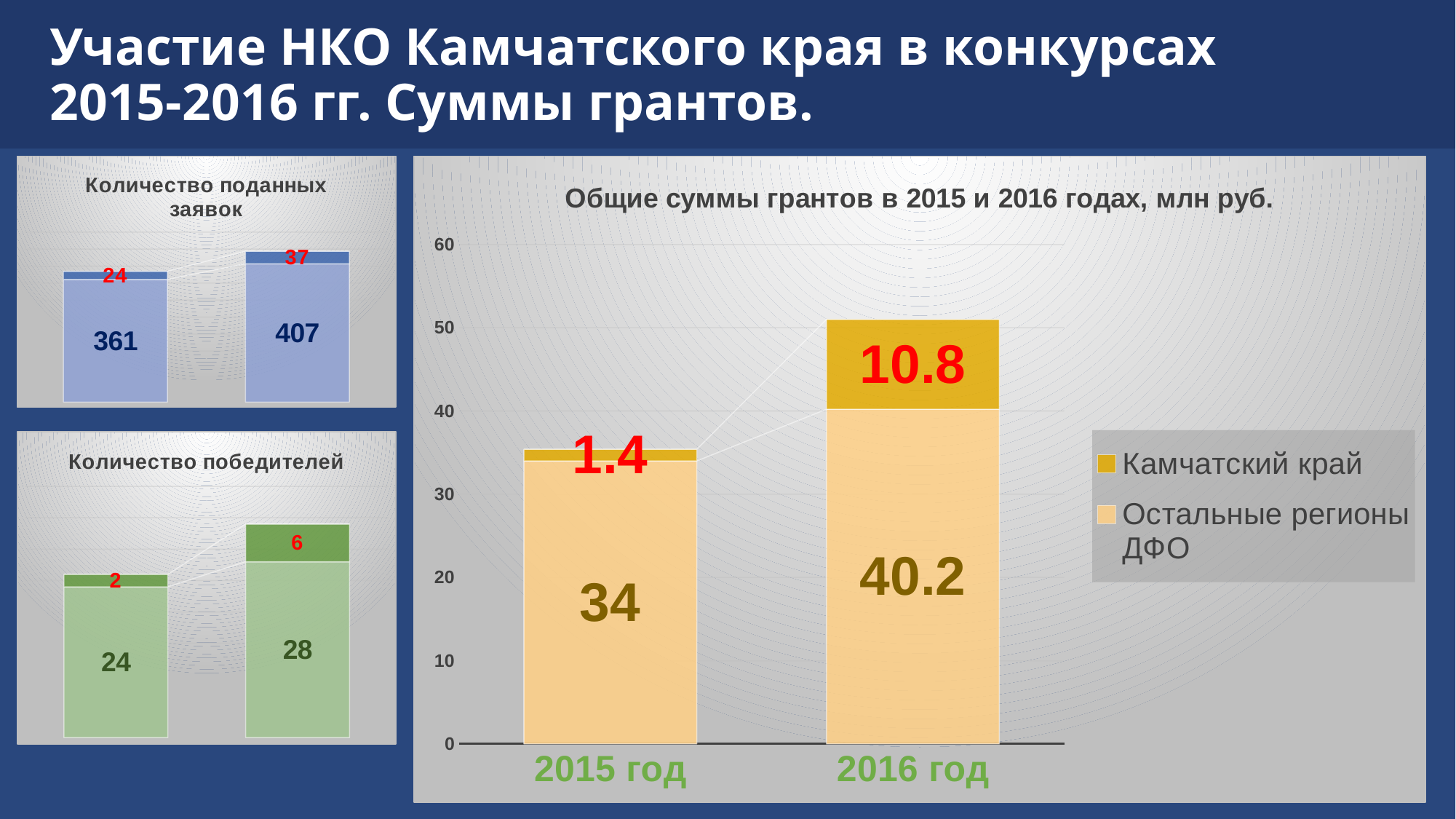
In the chart titled "Общие суммы грантов в 2015 и 2016 годах, млн руб.", which colour represents Камчатский край in the legend? dark yellow (gold) In the chart titled "Общие суммы грантов в 2015 и 2016 годах, млн руб.", what is the value for Остальные регионы ДФО in 2015 год? 34 In the chart titled "Общие суммы грантов в 2015 и 2016 годах, млн руб.", what is the total of the stacked bar for 2016 год? 51 In the chart titled "Общие суммы грантов в 2015 и 2016 годах, млн руб.", how many series does the legend list? 2 In the chart titled "Общие суммы грантов в 2015 и 2016 годах, млн руб.", what is the value for Камчатский край in 2016 год? 10.8 In the chart titled "Количество поданных заявок", what is the total of the left stacked bar? 385 What kind of chart is the chart titled "Общие суммы грантов в 2015 и 2016 годах, млн руб."? stacked bar chart In the chart titled "Количество победителей", what is the value of the small upper segment of the right bar? 6 In the chart titled "Общие суммы грантов в 2015 и 2016 годах, млн руб.", what is the difference between the Камчатский край values for 2016 год and 2015 год? 9.4 In the chart titled "Количество победителей", what is the difference between the lower segments of the right bar and the left bar? 4 In the chart titled "Количество поданных заявок", what is the value of the large lower segment of the right bar? 407 In the chart titled "Общие суммы грантов в 2015 и 2016 годах, млн руб.", does the total grant sum rise or fall from 2015 год to 2016 год? rise